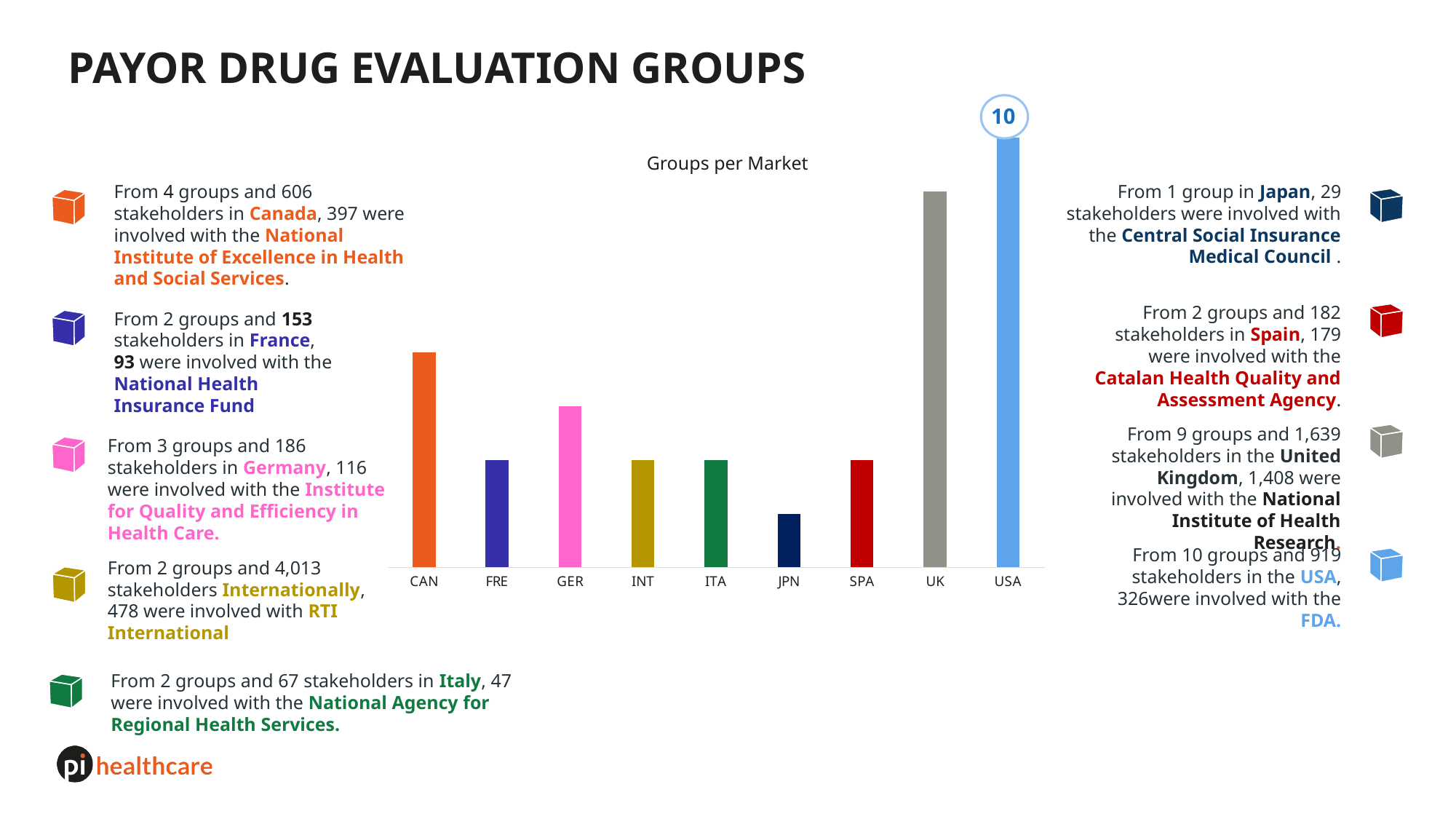
Which bar is taller, JPN or FRE? FRE Which market has the second-highest bar in the chart? UK Which market has the highest number of groups in the chart? USA Which bar is taller, UK or SPA? UK What value is labelled on the USA bar? 10 What is the title of the chart? Groups per Market Which market has the lowest number of groups in the chart? JPN What type of chart is shown on the slide? bar chart Which bar is taller, CAN or GER? CAN What colour is the USA bar in the chart? light blue How many markets (categories) are shown on the x axis of the chart? 9